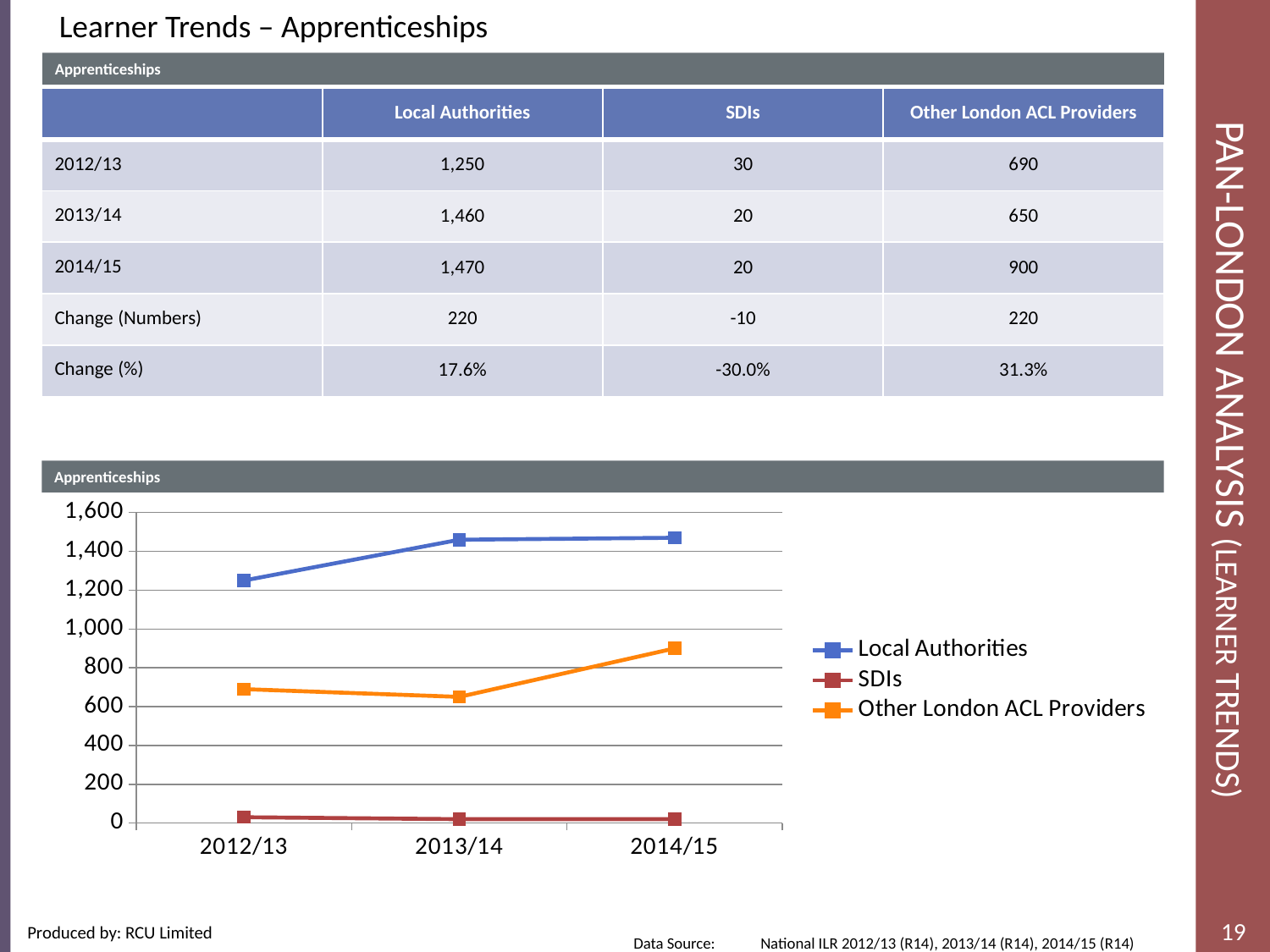
Which series has the highest value in 2014/15? Local Authorities What is the value for SDIs in 2013/14? 20 Is the value for Other London ACL Providers in 2013/14 greater or less than 800? less What colour is the line for Local Authorities in the chart? Blue What is the value for Other London ACL Providers in 2014/15? 900 Which series has the lowest value in 2012/13? SDIs How many points along the x axis does the chart show? 3 What is the difference between Local Authorities and Other London ACL Providers in 2013/14? 810 Does the Other London ACL Providers series rise or fall between 2013/14 and 2014/15? Rise How many series does the chart legend list? 3 What kind of chart is shown on the slide? Line chart What is the value for Local Authorities in 2012/13? 1,250